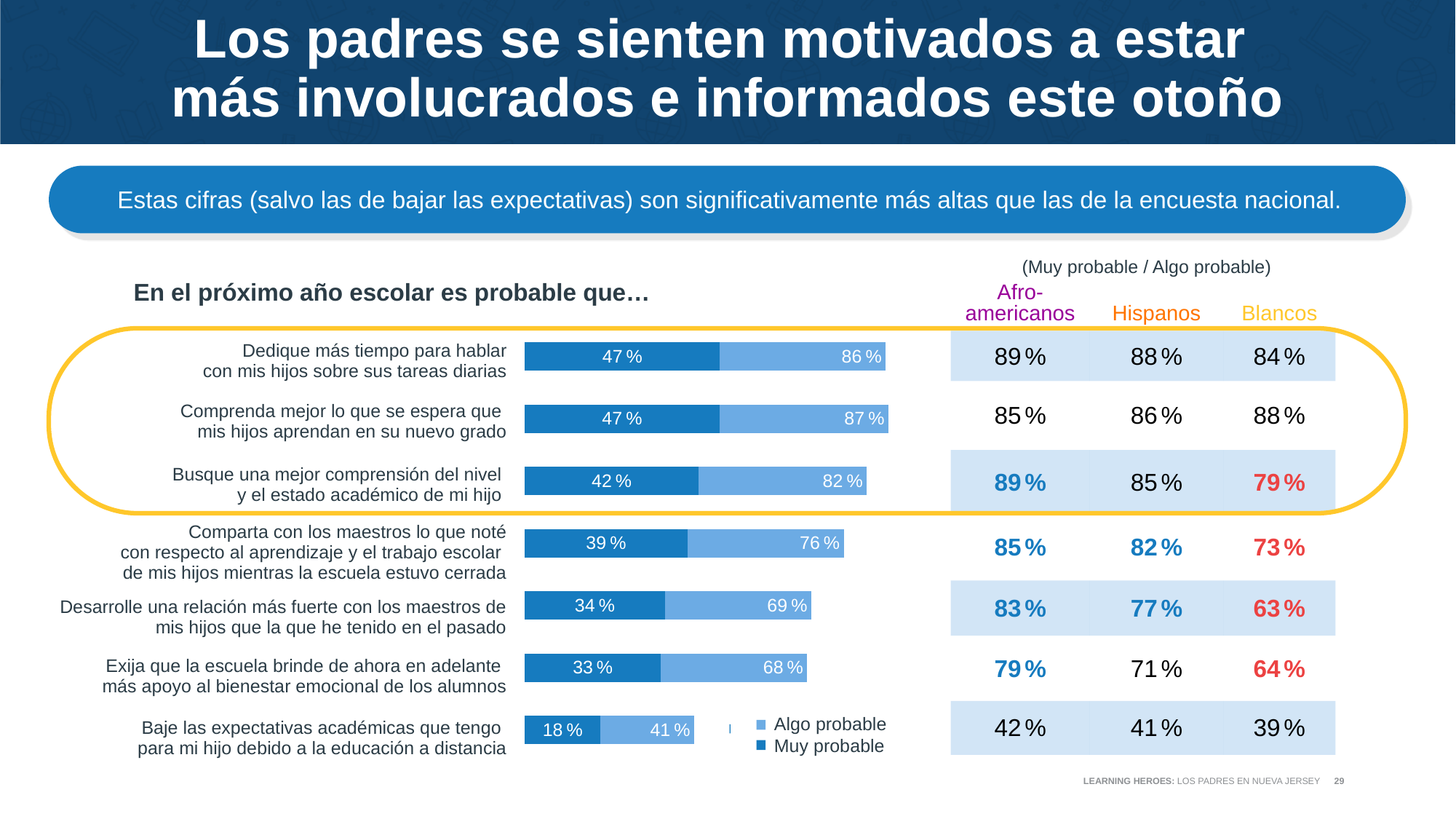
Do the "Muy probable" values increase or decrease going from the top bar to the bottom bar? Decrease Which category has the highest combined value printed at the end of its bar? Comprenda mejor lo que se espera que mis hijos aprendan en su nuevo grado How many categories (statements) are plotted in the bar chart? 7 What combined value is printed at the end of the bar for "Exija que la escuela brinde de ahora en adelante más apoyo al bienestar emocional de los alumnos"? 68 % What kind of chart is shown on the slide? Stacked horizontal bar chart What is the difference in "Muy probable" values between "Comparta con los maestros lo que noté..." (39 %) and "Desarrolle una relación más fuerte con los maestros..." (34 %)? 5 percentage points Which category has the lowest "Muy probable" value? Baje las expectativas académicas que tengo para mi hijo debido a la educación a distancia What is the "Muy probable" value for "Dedique más tiempo para hablar con mis hijos sobre sus tareas diarias"? 47 % What combined value is printed at the end of the bar for "Comprenda mejor lo que se espera que mis hijos aprendan en su nuevo grado"? 87 % Which has a larger "Muy probable" value: "Busque una mejor comprensión del nivel y el estado académico de mi hijo" or "Exija que la escuela brinde de ahora en adelante más apoyo al bienestar emocional de los alumnos"? Busque una mejor comprensión del nivel y el estado académico de mi hijo What is the "Muy probable" value for "Baje las expectativas académicas que tengo para mi hijo debido a la educación a distancia"? 18 % How many series does the chart legend list? 2